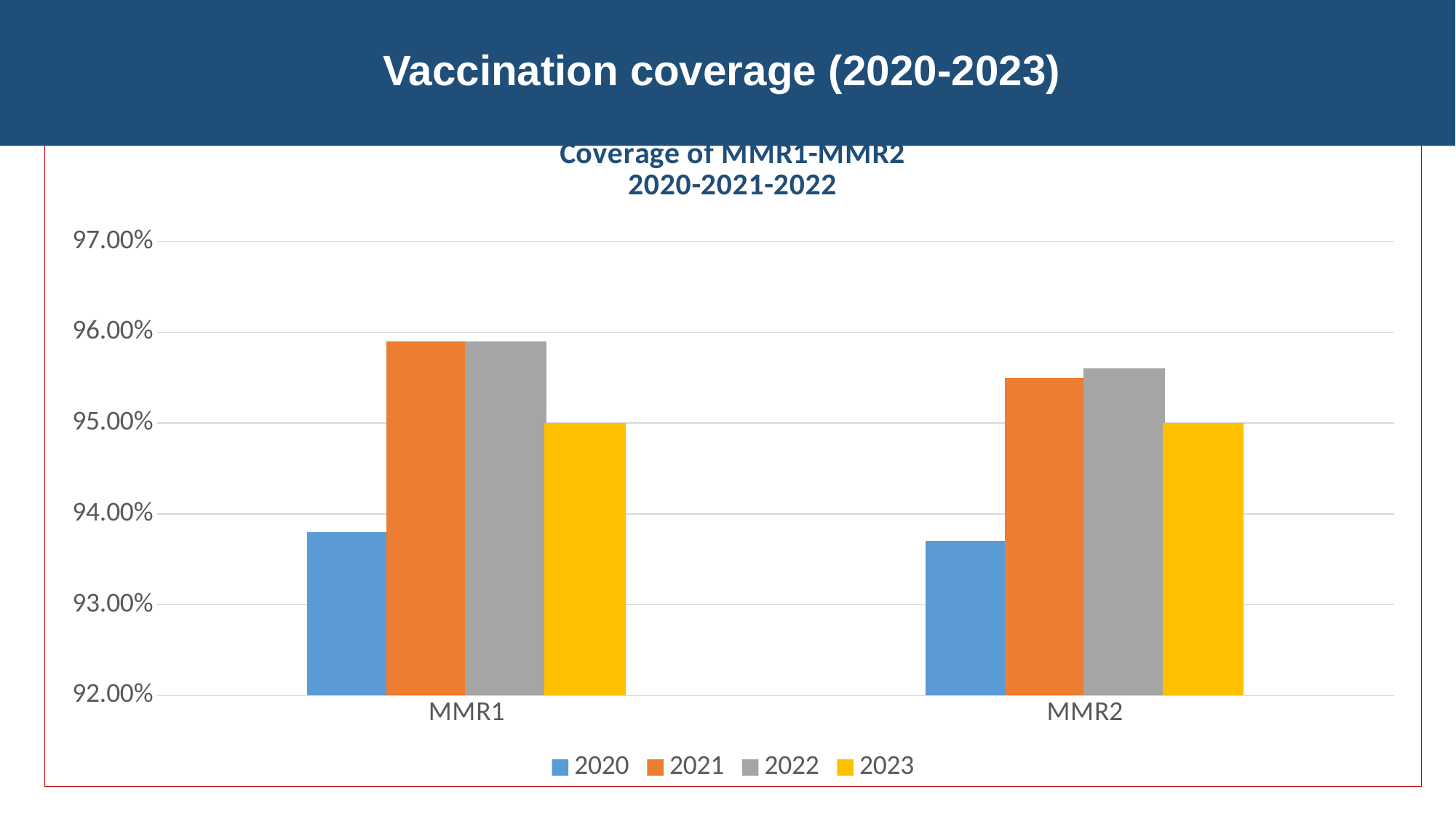
Is the value for 2020 in the MMR1 group greater or less than 94.00%? less Which year has the lowest coverage in the MMR1 group? 2020 Which year has the lowest coverage in the MMR2 group? 2020 What kind of chart is shown on the slide? Bar chart What is the coverage value for 2023 in the MMR2 group? 95.00% Is the value for 2021 in the MMR1 group greater or less than 96.00%? less What is the coverage value for 2023 in the MMR1 group? 95.00% Which is larger: the 2021 value for MMR1 or the 2021 value for MMR2? MMR1 How many categories are shown on the x axis? 2 Is the value for 2021 in the MMR2 group greater or less than 95.00%? greater How many series does the legend list? 4 What is the title of the chart? Coverage of MMR1-MMR2 2020-2021-2022